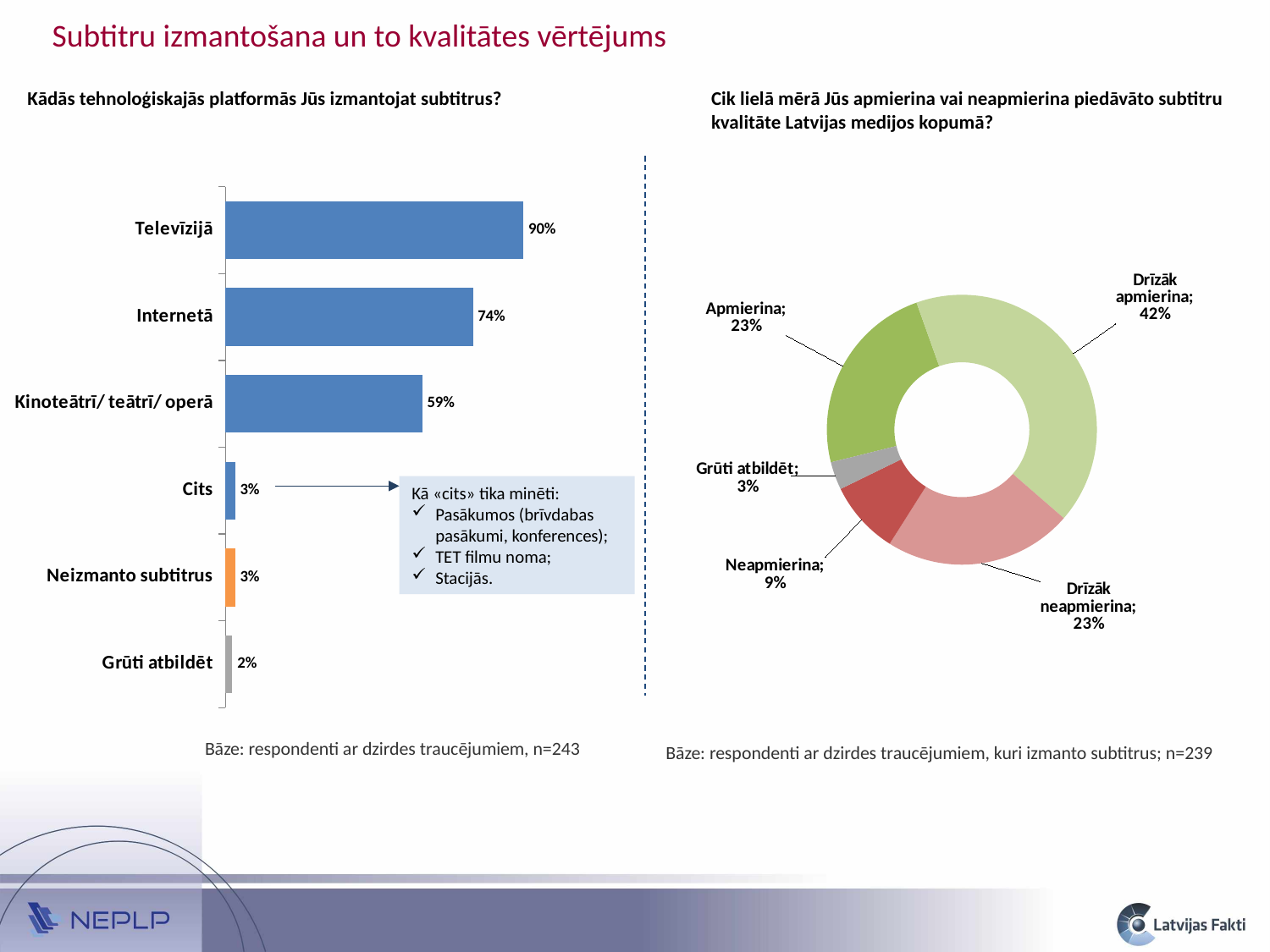
In the left bar chart, which category has the lowest value? Grūti atbildēt What kind of chart is on the left side of the slide? Bar chart In the right donut chart, what is the difference between the shares for Drīzāk apmierina and Drīzāk neapmierina? 19% In the left bar chart, which category has the highest value? Televīzijā In the right donut chart (Cik lielā mērā Jūs apmierina vai neapmierina piedāvāto subtitru kvalitāte Latvijas medijos kopumā?), what is the share for Drīzāk apmierina? 42% In the left bar chart (Kādās tehnoloģiskajās platformās Jūs izmantojat subtitrus?), what is the value for Televīzijā? 90% In the left bar chart, what is the value for Kinoteātrī/ teātrī/ operā? 59% In the right donut chart, which category has the largest share? Drīzāk apmierina In the right donut chart, what is the value for Neapmierina? 9% In the left bar chart, what is the difference between the values for Televīzijā and Internetā? 16% How many categories does the left bar chart show? 6 In the left bar chart, which is larger: the value for Internetā or for Kinoteātrī/ teātrī/ operā? Internetā